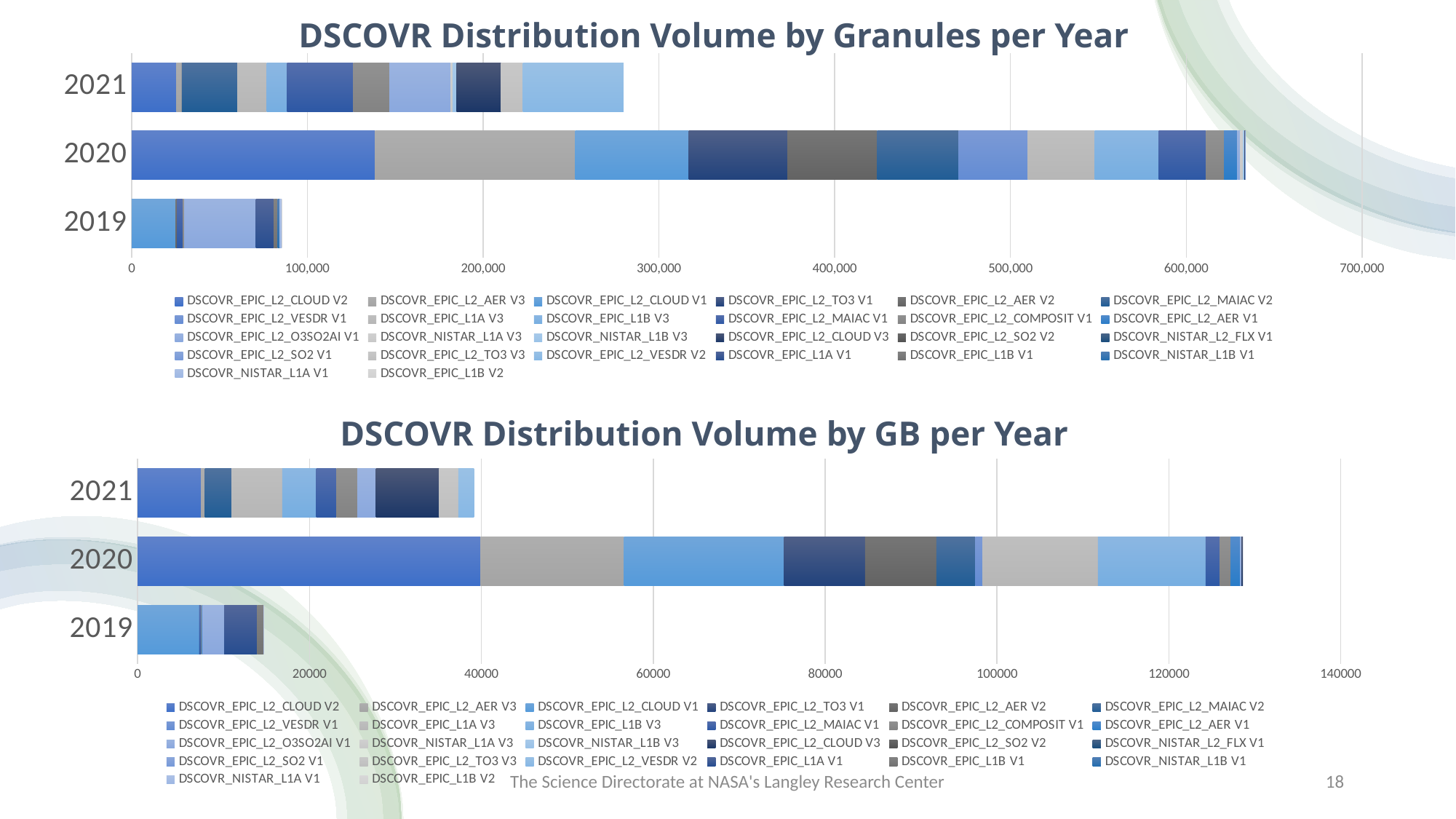
In the 'DSCOVR Distribution Volume by Granules per Year' chart, is the total for 2019 greater or less than 100,000? less What is the title of the top chart on the slide? DSCOVR Distribution Volume by Granules per Year In the 'DSCOVR Distribution Volume by GB per Year' chart, which year has the smallest total bar? 2019 In the 'DSCOVR Distribution Volume by GB per Year' chart, is the total for 2019 greater or less than 20000? less In the 'DSCOVR Distribution Volume by GB per Year' chart, is the total for 2020 greater or less than 120000? greater What kind of chart is the 'DSCOVR Distribution Volume by Granules per Year' chart? Stacked bar chart In the 'DSCOVR Distribution Volume by Granules per Year' chart, which year has the largest total bar? 2020 How many series does the legend of the 'DSCOVR Distribution Volume by Granules per Year' chart list? 26 How many years are shown on the 'DSCOVR Distribution Volume by GB per Year' chart? 3 In the 'DSCOVR Distribution Volume by GB per Year' chart, which total is larger, 2021 or 2019? 2021